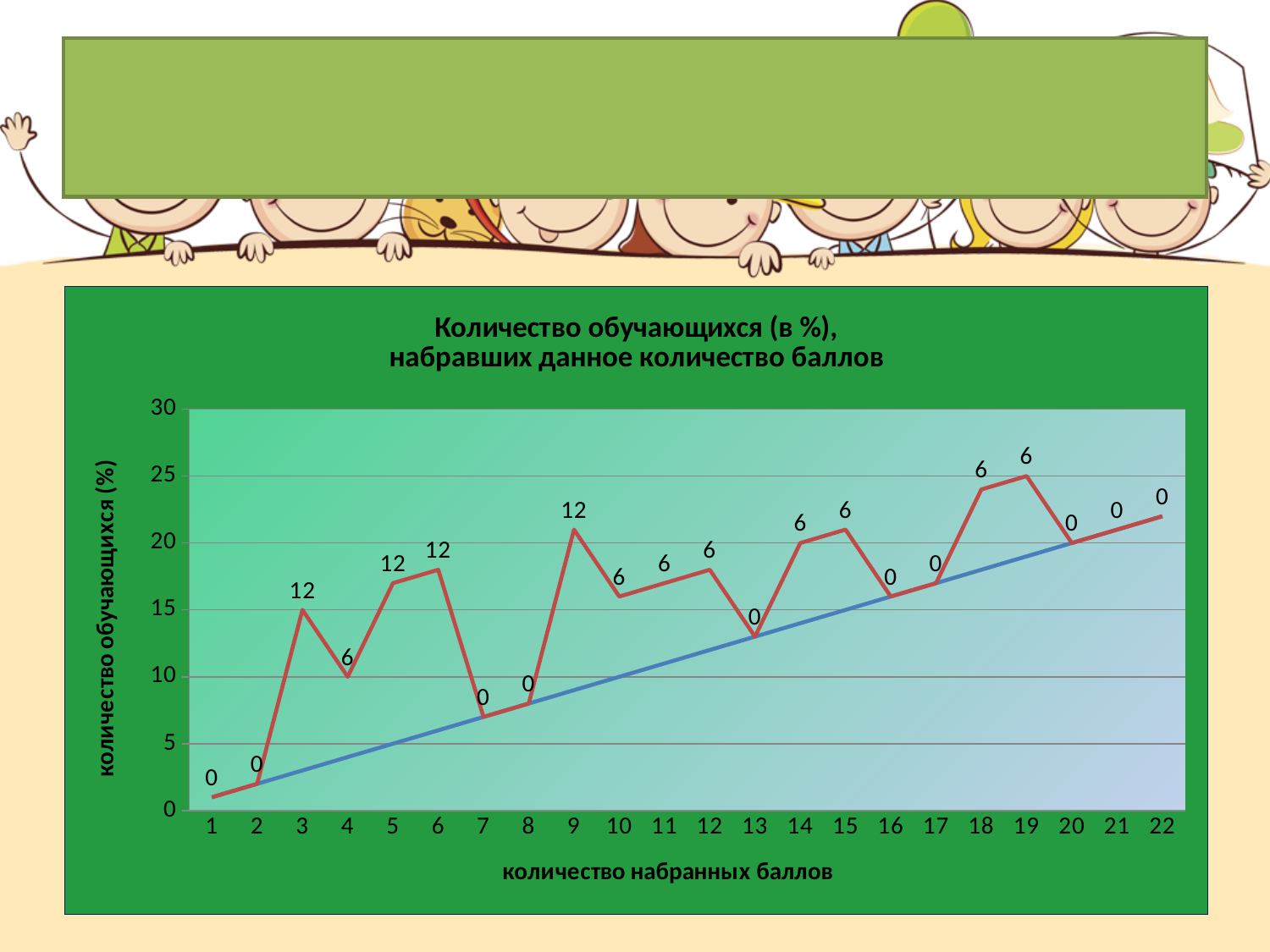
What is the data label for a score of 13? 0 How many score categories are shown on the x axis? 22 What is the data label for a score of 4? 6 What is the data label for a score of 9? 12 What is the data label for a score of 18? 6 Which has the larger data label, a score of 5 or a score of 10? 5 What is the label of the x axis? количество набранных баллов What is the data label for a score of 3? 12 What is the difference between the data labels for scores 3 and 4? 6 What is the data label for a score of 22? 0 What type of chart is shown on the slide? line chart What is the title of the chart? Количество обучающихся (в %), набравших данное количество баллов